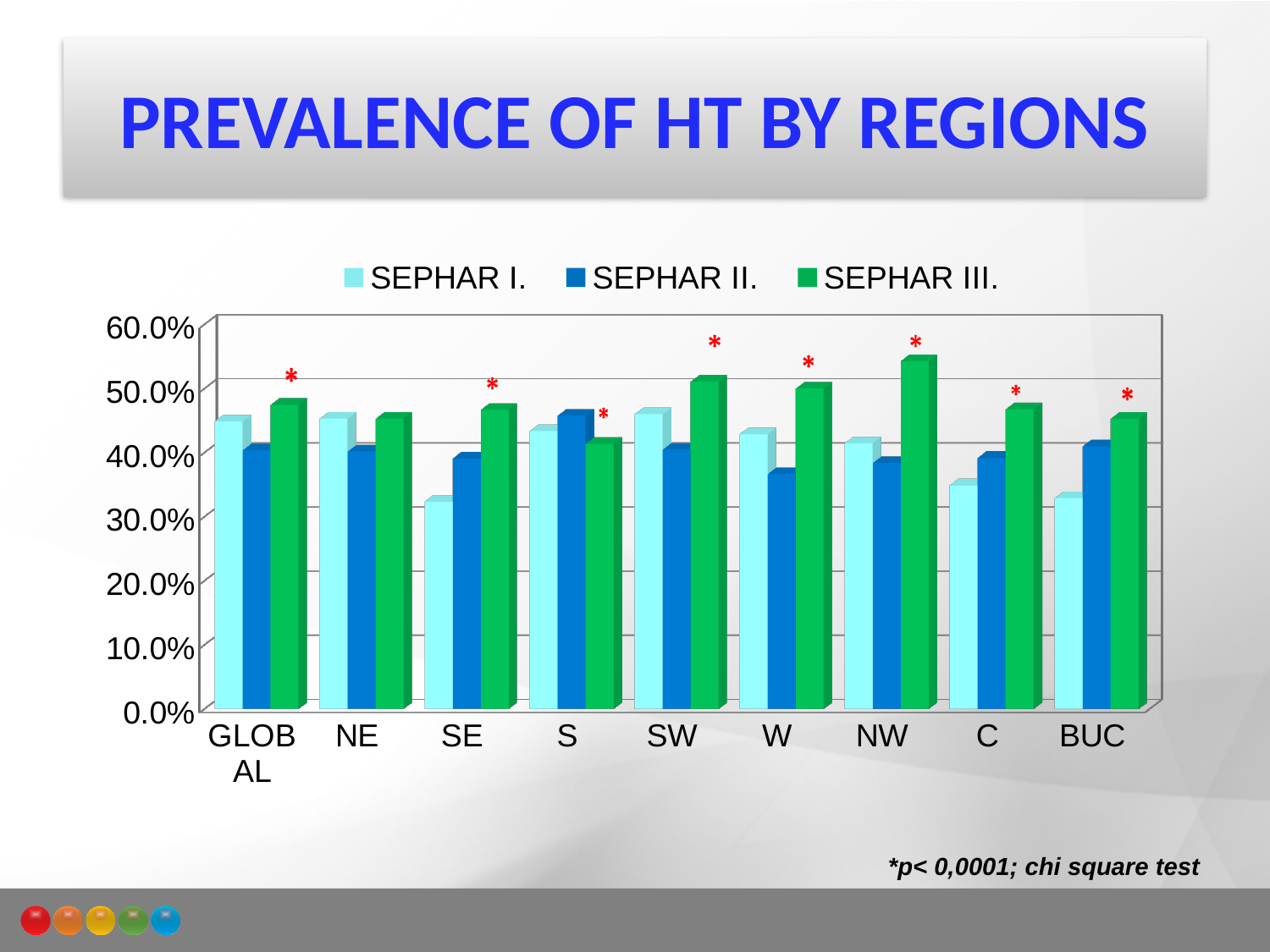
Is the SEPHAR III. value for NW greater or less than 50.0%? greater Which region has the highest SEPHAR II. value? S Which region has the highest SEPHAR III. value? NW What is the title of the chart on the slide? PREVALENCE OF HT BY REGIONS What kind of chart is shown on the slide? bar chart Is the SEPHAR II. value for W greater or less than 40.0%? less How many regions (categories) are shown on the x axis? 9 For region S, which is larger: the SEPHAR II. value or the SEPHAR III. value? SEPHAR II. Is the SEPHAR I. value for SE greater or less than 40.0%? less How many series does the legend list? 3 Which region has the lowest SEPHAR III. value? S For region SE, which is larger: the SEPHAR I. value or the SEPHAR III. value? SEPHAR III.